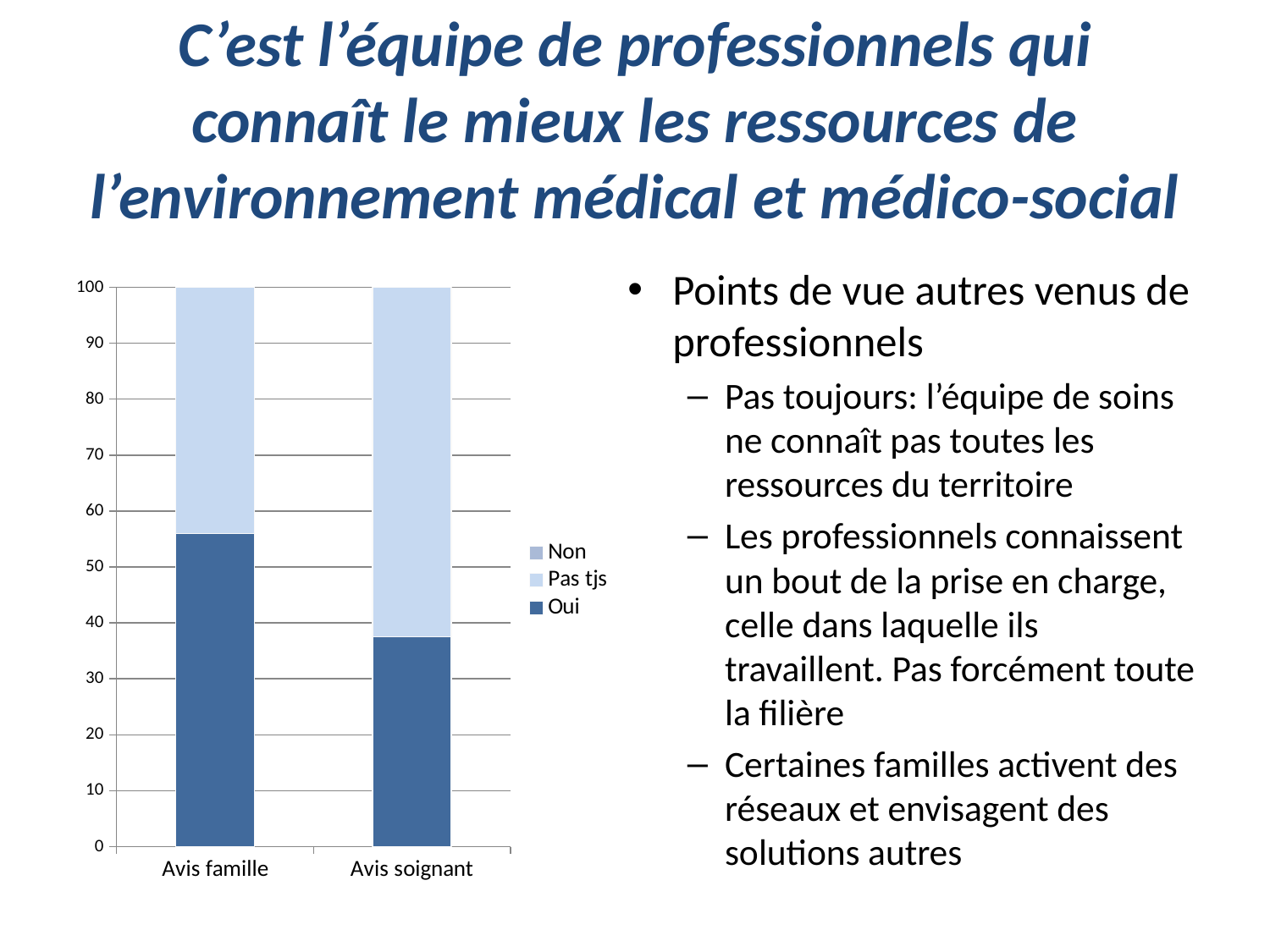
How many categories are shown on the x axis of the chart? 2 Is the 'Oui' value for Avis famille greater or less than 50? greater What are the three entries listed in the chart legend? Non, Pas tjs, Oui Is the 'Oui' value for Avis soignant greater or less than 50? less How many series does the chart legend list? 3 Is the 'Oui' value for Avis famille greater or less than 60? less What is the label of the second category on the x axis? Avis soignant What kind of chart is shown on the slide? stacked bar chart Which category has the larger 'Oui' value, Avis famille or Avis soignant? Avis famille What is the total height of the stacked bar for Avis famille? 100 Which category has the highest 'Oui' value? Avis famille